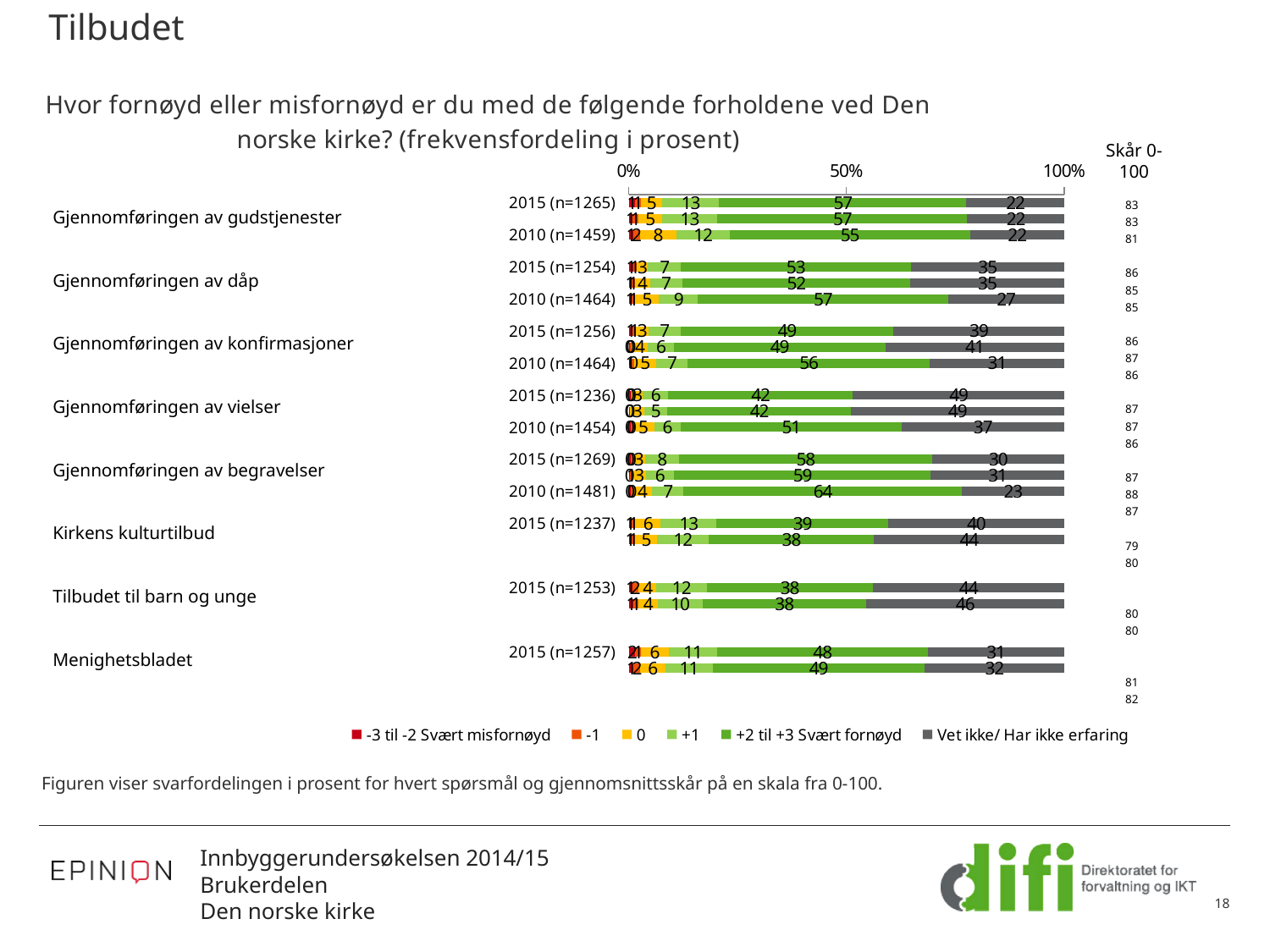
What is the 'Skår 0-100' value shown for 'Gjennomføringen av gudstjenester' in 2015? 83 What is the value of 'Vet ikke/ Har ikke erfaring' for 'Gjennomføringen av vielser' in 2015 (n=1236)? 49 What is the value of '+2 til +3 Svært fornøyd' for 'Gjennomføringen av gudstjenester' in 2015 (n=1265)? 57 What is the value of '+1' for 'Kirkens kulturtilbud' in 2015 (n=1237)? 13 Among the 2015 bars, which category has the highest 'Vet ikke/ Har ikke erfaring' value? Gjennomføringen av vielser How many series does the legend list? 6 What kind of chart is shown on the slide? Stacked bar chart What is the difference between the '+2 til +3 Svært fornøyd' values for 'Gjennomføringen av begravelser' in 2010 (n=1481) and 2015 (n=1269)? 6 Which has the larger 'Vet ikke/ Har ikke erfaring' value in 2015: 'Gjennomføringen av dåp' (n=1254) or 'Gjennomføringen av konfirmasjoner' (n=1256)? Gjennomføringen av konfirmasjoner Is the '+2 til +3 Svært fornøyd' value for 'Tilbudet til barn og unge' in 2015 (n=1253) greater or less than 50? less What is the value of '+2 til +3 Svært fornøyd' for 'Gjennomføringen av begravelser' in 2010 (n=1481)? 64 How many question categories (row labels) are shown in the chart? 8